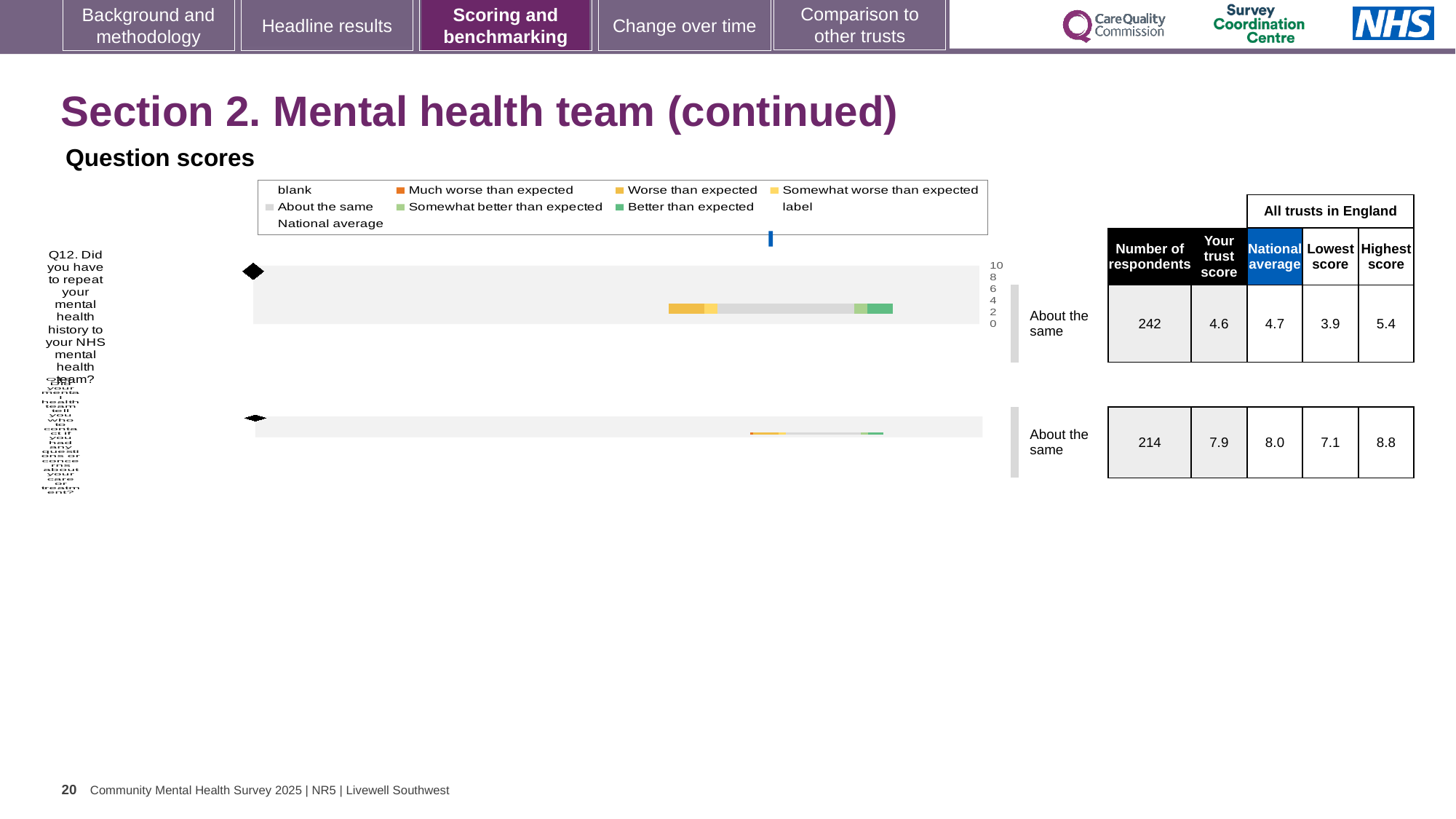
For the Q12 chart, what is the highest score among all trusts in England? 5.4 What kind of chart is used to show the question scores on this slide? bar chart For the lower chart on the slide, what is the difference between the national average (8.0) and the trust's score (7.9)? 0.1 For the lower chart on the slide, how many respondents are listed in the table? 214 For the lower chart on the slide, what is the trust's score? 7.9 For the Q12 chart, which is larger: the trust's score or the national average? national average For the Q12 chart, what is the difference between the highest score (5.4) and the lowest score (3.9) among all trusts in England? 1.5 For the Q12 chart, what is the trust's score? 4.6 For the lower chart on the slide, what is the lowest score among all trusts in England? 7.1 For the Q12 chart, how many respondents are listed in the table? 242 For the Q12 chart (Did you have to repeat your mental health history to your NHS mental health team?), what benchmark category is shown next to the bar? About the same For the Q12 chart, what is the national average score? 4.7